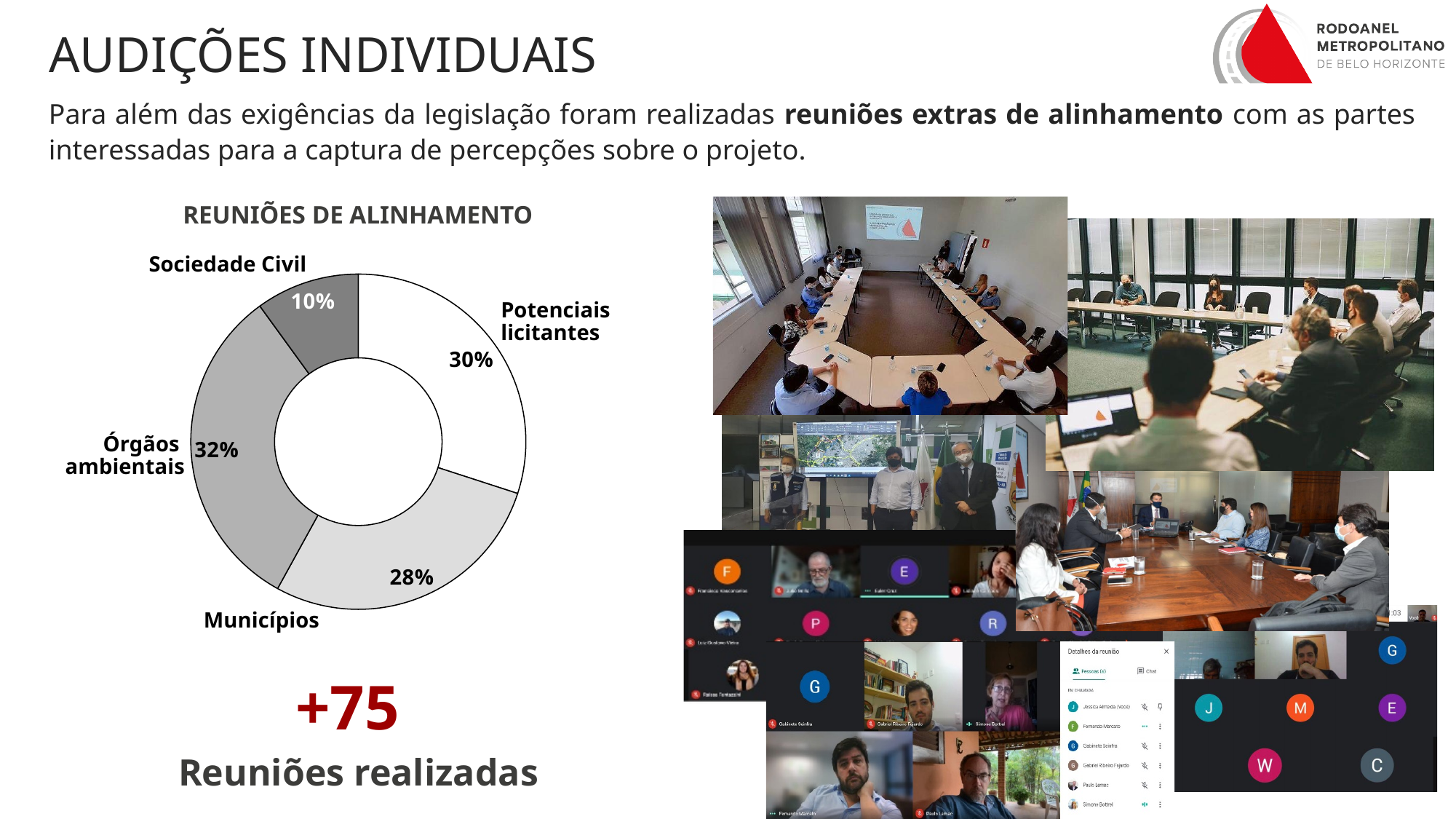
What percentage is shown for Órgãos ambientais? 32% Which category has the smallest share of the alignment meetings? Sociedade Civil Which category has the largest share of the alignment meetings? Órgãos ambientais What percentage of the alignment meetings were with Potenciais licitantes? 30% What is the combined share of Potenciais licitantes and Municípios? 58% What percentage is shown for Sociedade Civil? 10% What is the difference in percentage points between Órgãos ambientais and Sociedade Civil? 22 percentage points How many categories are shown in the donut chart? 4 What is the title of the donut chart? REUNIÕES DE ALINHAMENTO Which is larger, the share for Potenciais licitantes or the share for Municípios? Potenciais licitantes What share of the chart does Municípios represent? 28% What type of chart is shown under the title "REUNIÕES DE ALINHAMENTO"? Pie chart (donut)